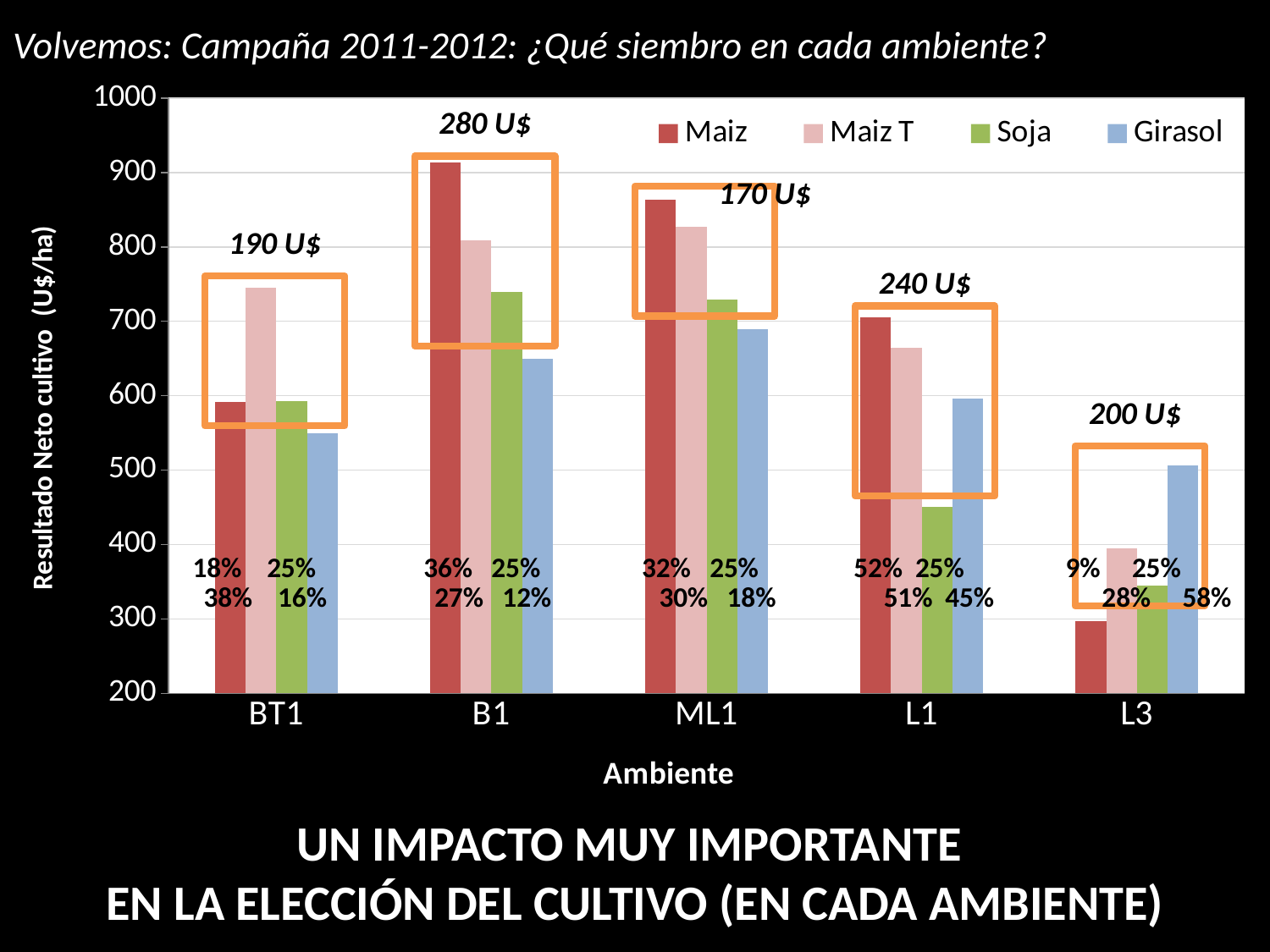
Is the value for Maiz in ML1 greater or less than 800? greater Which series has the highest bar in the L3 category? Girasol Is the value for Girasol in B1 greater or less than 600? greater How many categories (ambientes) are shown on the x axis? 5 What annotation is written above the orange box for the B1 category? 280 U$ In which category does Maiz reach its highest value? B1 In the L1 category, which is larger, the Maiz bar or the Girasol bar? Maiz In which category does Maiz have its lowest value? L3 How many series does the legend list? 4 Which series has the highest bar in the BT1 category? Maiz T Is the value for Soja in L1 greater or less than 500? less What kind of chart is shown on the slide? bar chart